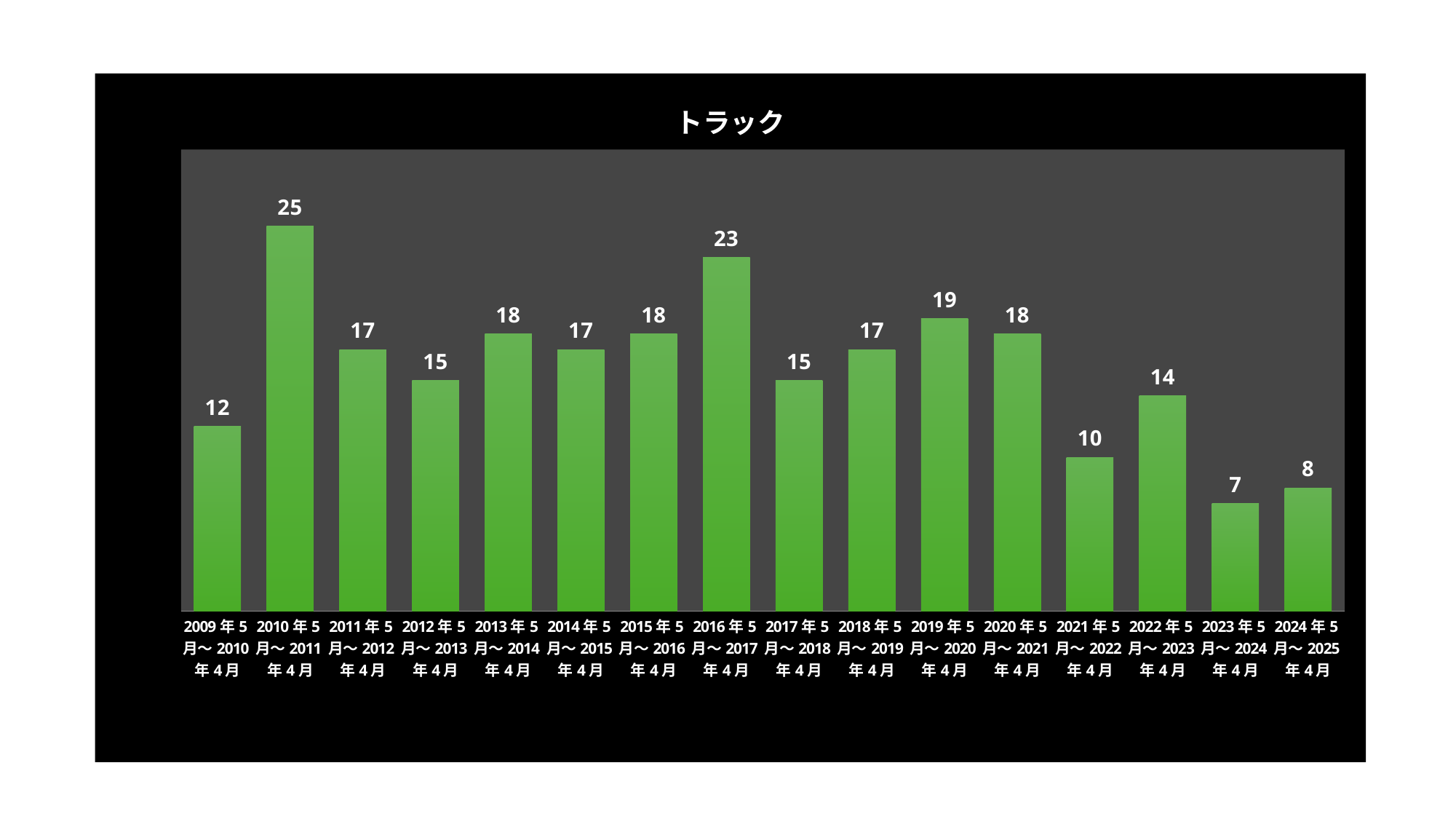
What is the value for 2023年5月～2024年4月? 7 How many periods are shown on the x axis? 16 What is the value for 2019年5月～2020年4月? 19 What is the title of the chart? トラック What is the difference between the values for 2010年5月～2011年4月 and 2009年5月～2010年4月? 13 What is the value for 2010年5月～2011年4月? 25 What is the value for 2016年5月～2017年4月? 23 Which is larger, the value for 2016年5月～2017年4月 or the value for 2019年5月～2020年4月? 2016年5月～2017年4月 What kind of chart is this? Bar chart Which period has the highest value? 2010年5月～2011年4月 What is the difference between the values for 2022年5月～2023年4月 and 2024年5月～2025年4月? 6 Which period has the lowest value? 2023年5月～2024年4月